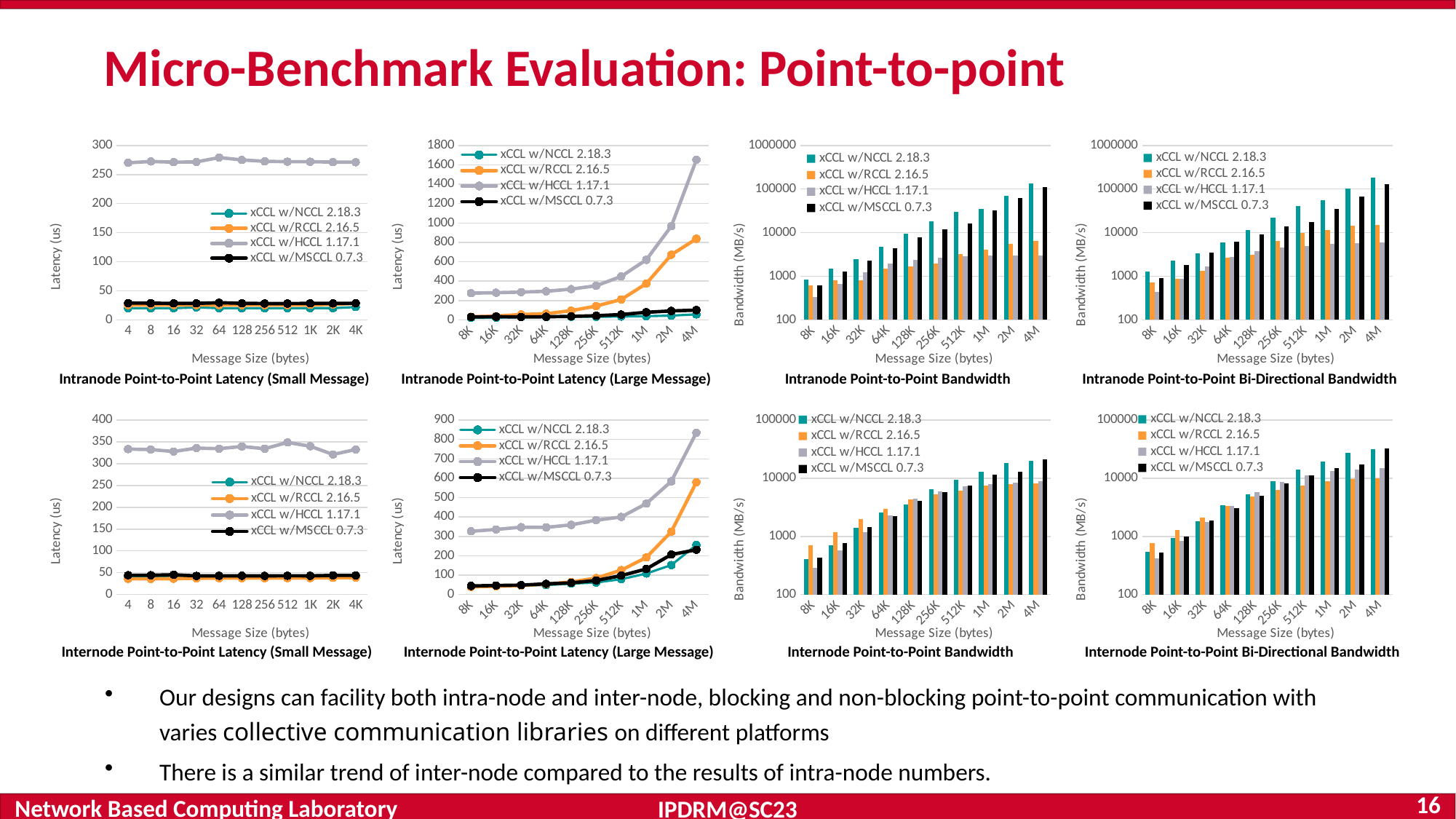
In the Internode Point-to-Point Bi-Directional Bandwidth chart, how many series does the legend list? 4 In the Intranode Point-to-Point Latency (Small Message) chart, how many message sizes are shown on the x axis? 11 In the Intranode Point-to-Point Bandwidth chart, how many message sizes are shown on the x axis? 10 In the Intranode Point-to-Point Bandwidth chart, what kind of chart is shown? bar chart In the Intranode Point-to-Point Latency (Small Message) chart, which series has the highest latency across all message sizes? xCCL w/HCCL 1.17.1 In the Intranode Point-to-Point Latency (Large Message) chart, does the latency for xCCL w/HCCL 1.17.1 rise or fall as message size increases? rise In the Intranode Point-to-Point Latency (Large Message) chart, is the latency for xCCL w/HCCL 1.17.1 at 4M greater or less than 1400? greater In the Intranode Point-to-Point Latency (Small Message) chart, how many series does the legend list? 4 In the Internode Point-to-Point Latency (Small Message) chart, is the latency for xCCL w/HCCL 1.17.1 at 4 bytes greater or less than 300? greater In the Internode Point-to-Point Bandwidth chart, does the bandwidth for xCCL w/NCCL 2.18.3 rise or fall as message size increases? rise In the Internode Point-to-Point Latency (Large Message) chart, at 4M which series has the higher latency, xCCL w/RCCL 2.16.5 or xCCL w/NCCL 2.18.3? xCCL w/RCCL 2.16.5 In the Intranode Point-to-Point Latency (Small Message) chart, what kind of chart is shown? line chart